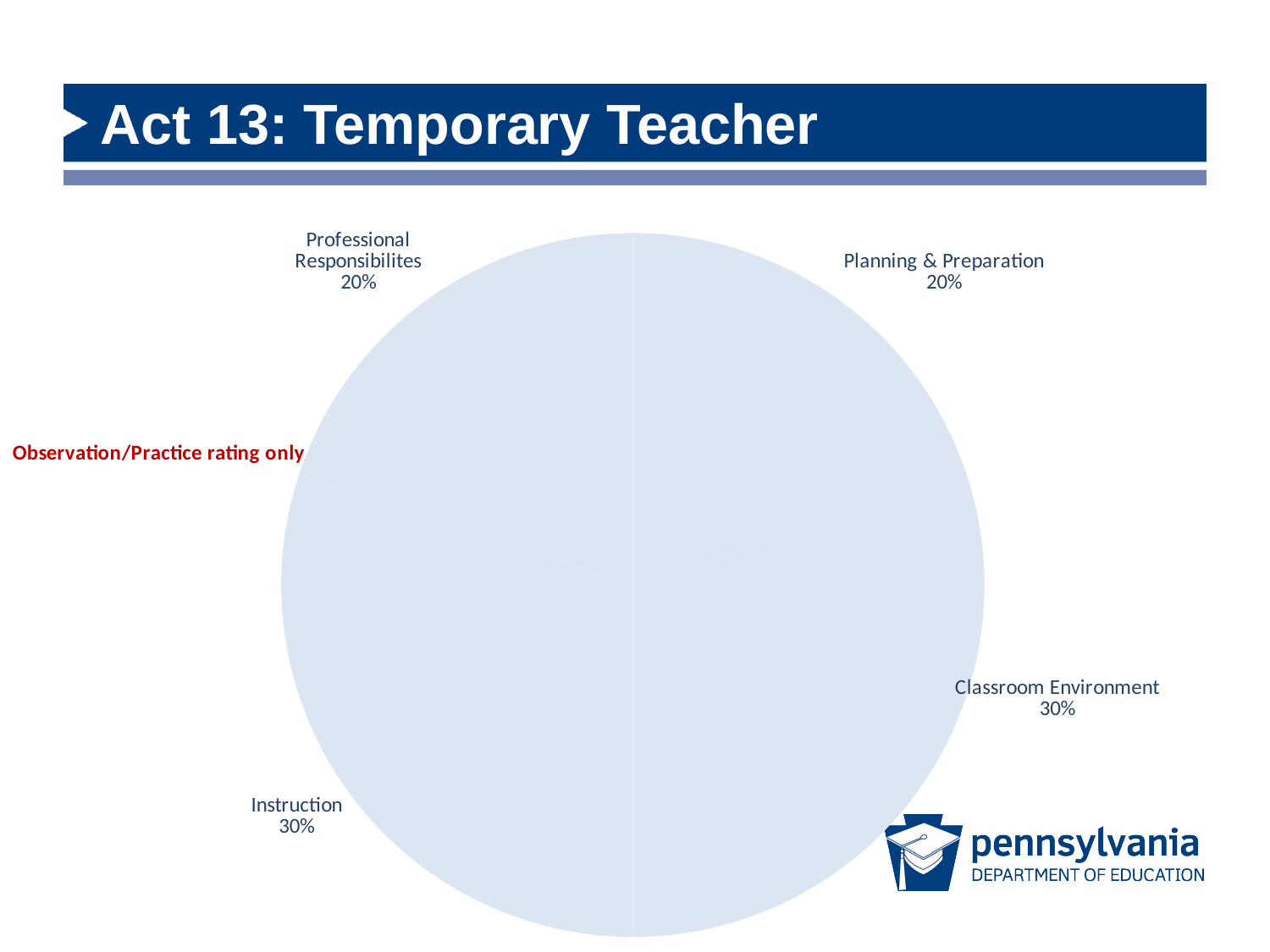
What is the title of the slide containing the pie chart? Act 13: Temporary Teacher What percentage is shown for Professional Responsibilites in the pie chart? 20% What percentage is shown for Classroom Environment in the pie chart? 30% How many categories are shown in the pie chart? 4 What is the difference between the Instruction and Planning & Preparation percentages? 10% What share of the pie does Instruction represent? 30% What percentage is shown for Instruction in the pie chart? 30% What does the red text to the left of the pie chart say? Observation/Practice rating only What percentage is shown for Planning & Preparation in the pie chart? 20% Which is larger, Classroom Environment or Planning & Preparation? Classroom Environment Which is larger, Instruction or Professional Responsibilites? Instruction What kind of chart is shown on the slide? Pie chart